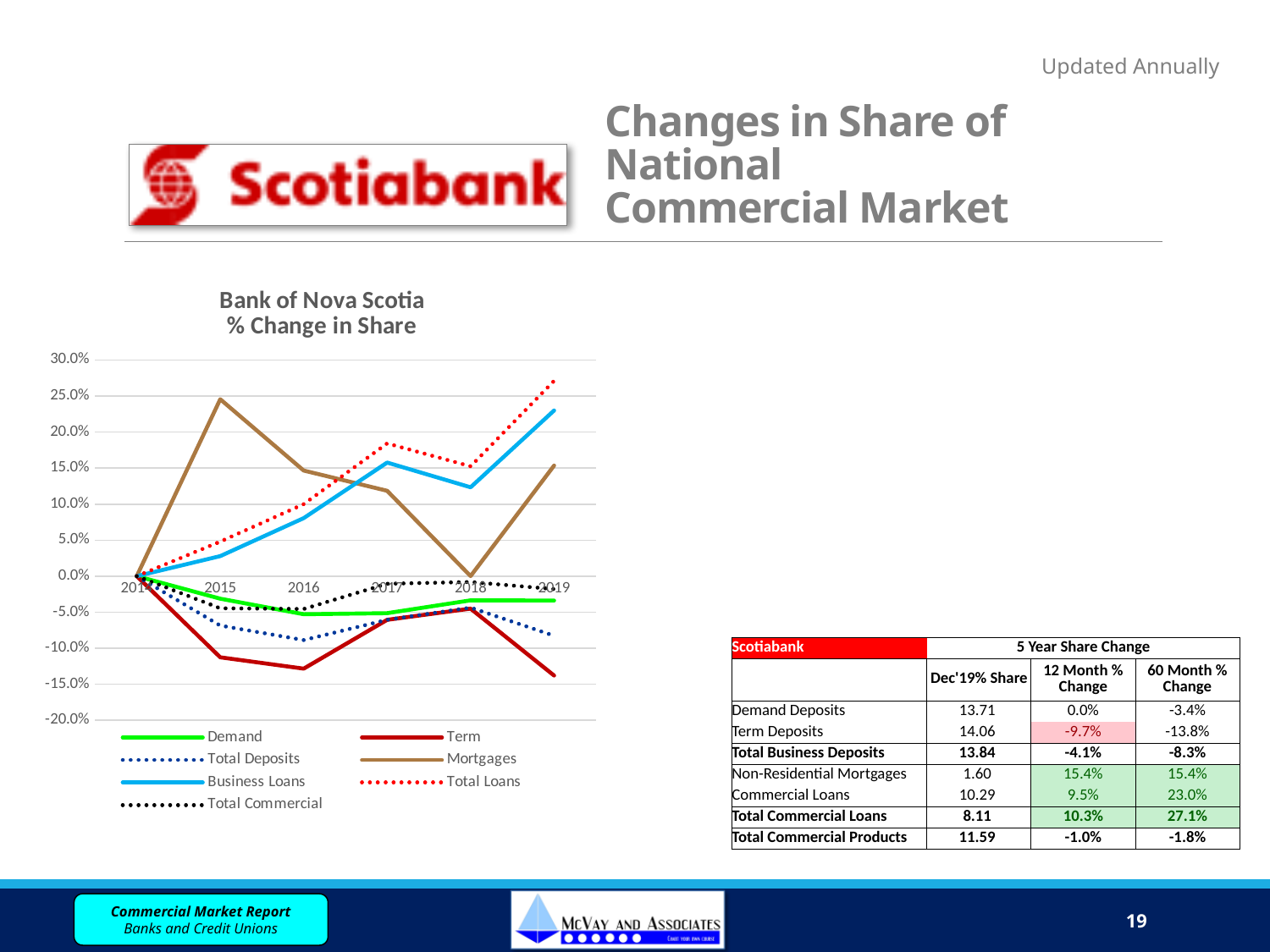
How many years are shown along the x axis of the chart? 6 Does the Term series rise or fall from 2014 to 2016? fall Is the value for Mortgages in 2015 greater or less than 20.0%? greater Is the value for Term in 2016 greater or less than -10.0%? less What kind of chart is shown on the slide? line chart How many series does the chart legend list? 7 Which series has the highest value in 2015? Mortgages Is the value for Business Loans in 2019 greater or less than 20.0%? greater What is the title of the chart? Bank of Nova Scotia % Change in Share Which series has the highest value in 2019? Total Loans Which series has the lowest value in 2019? Term In 2019, which is larger, Business Loans or Mortgages? Business Loans